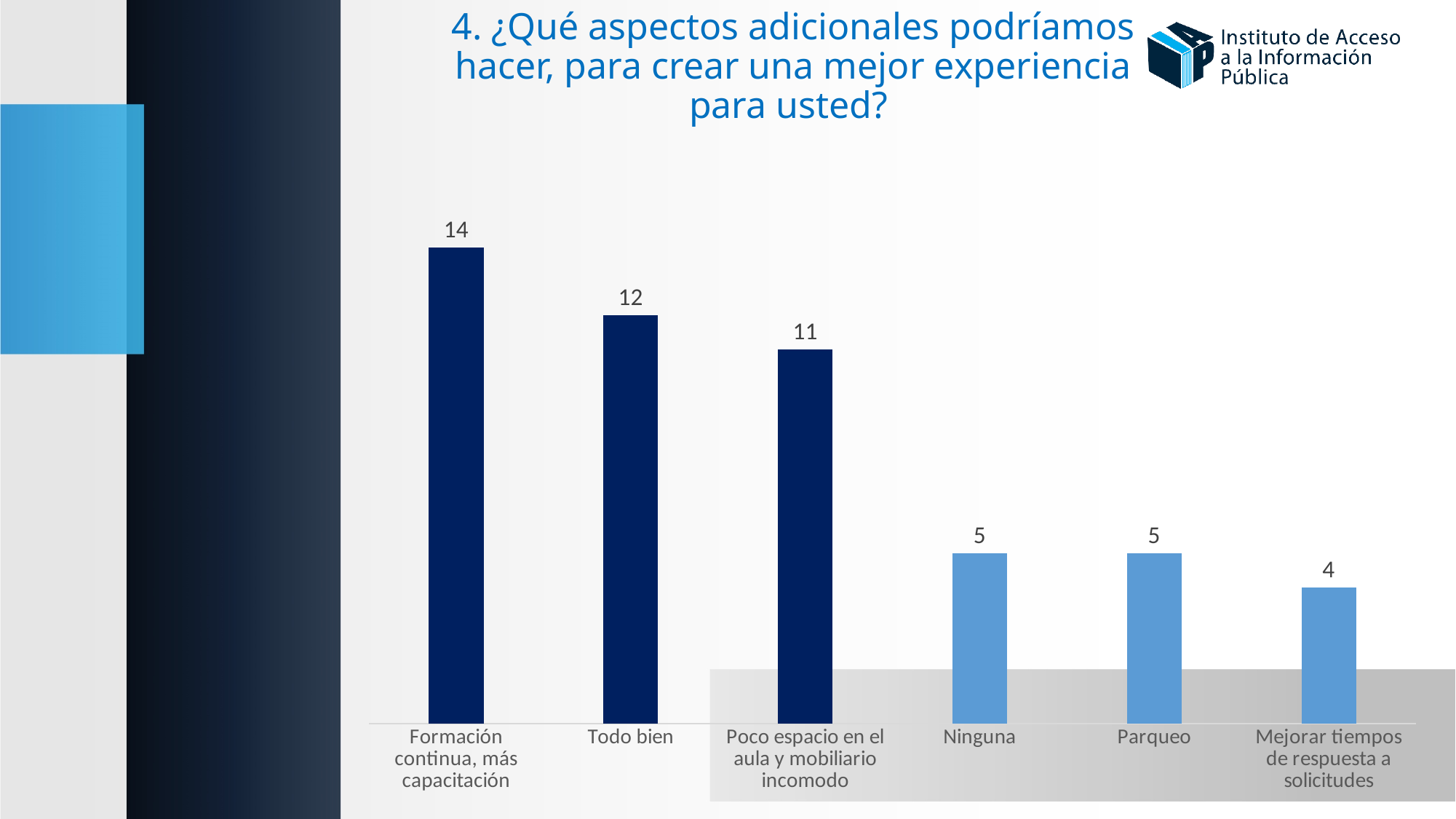
What is the value for "Formación continua, más capacitación"? 14 What is the value for "Todo bien"? 12 What is the difference between the values for "Poco espacio en el aula y mobiliario incomodo" and "Parqueo"? 6 What kind of chart is shown on the slide? Bar chart Do the values rise or fall from left to right along the x axis? Fall Which is larger, the value for "Todo bien" or the value for "Ninguna"? Todo bien Which category has the highest value? Formación continua, más capacitación How many categories are shown in the chart? 6 What is the value for "Poco espacio en el aula y mobiliario incomodo"? 11 What is the difference between the values for "Formación continua, más capacitación" and "Todo bien"? 2 What is the value for "Mejorar tiempos de respuesta a solicitudes"? 4 Which category has the lowest value? Mejorar tiempos de respuesta a solicitudes